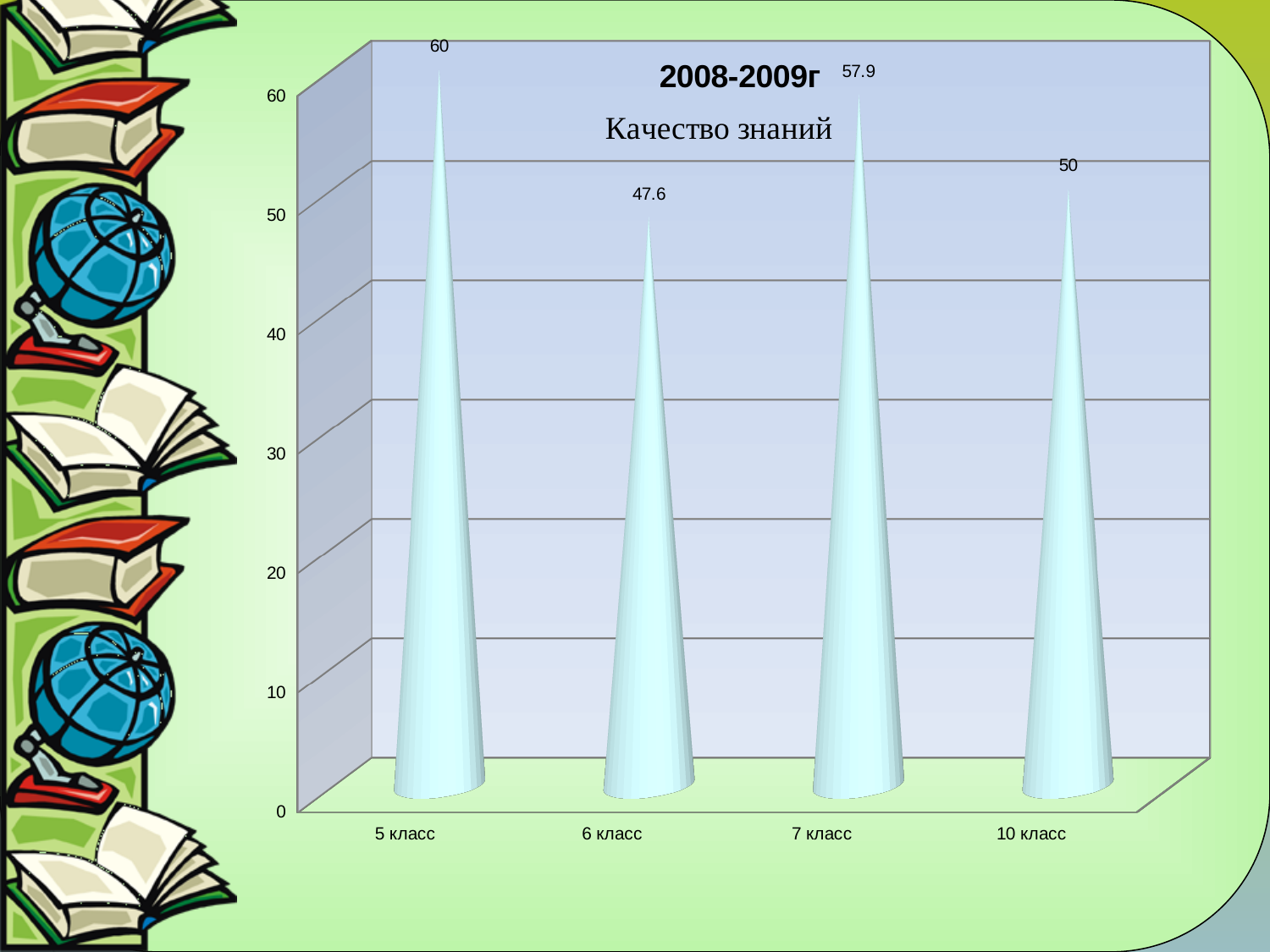
What is the value for 6 класс? 47.6 What school year is shown in the chart title? 2008-2009г Which is larger, the value for 7 класс or the value for 10 класс? 7 класс What is the value for 7 класс? 57.9 What is the difference between the values for 5 класс and 6 класс? 12.4 Which class has the lowest value? 6 класс What is the value for 10 класс? 50 What is the value for 5 класс? 60 How many classes are shown on the chart? 4 What is the difference between the values for 7 класс and 10 класс? 7.9 What kind of chart is shown on the slide? bar chart Which class has the highest value? 5 класс